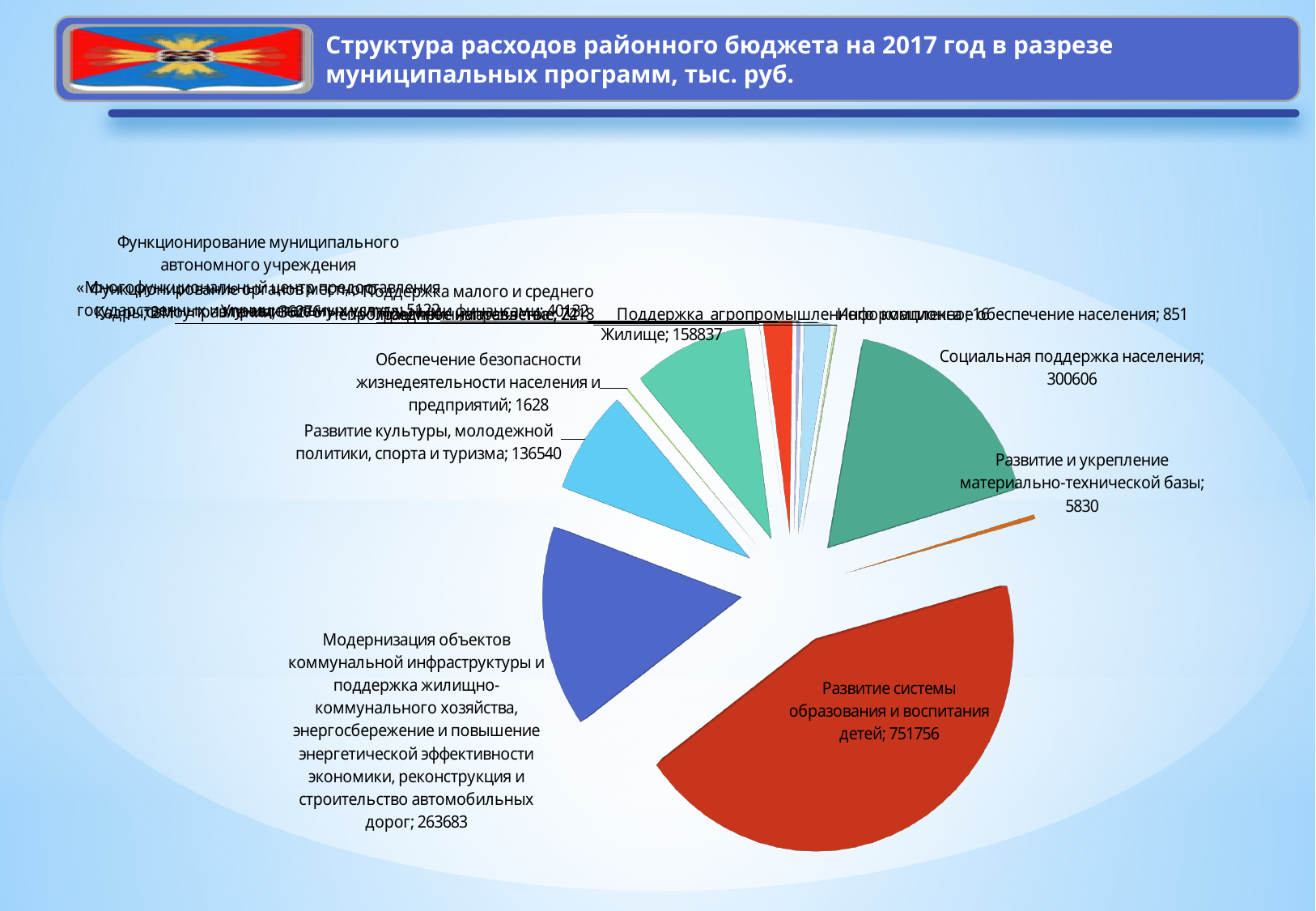
What kind of chart is shown on the slide? pie chart What is the value for «Социальная поддержка населения»? 300606 Which program has the largest slice of the pie? Развитие системы образования и воспитания детей What is the value for «Информационное обеспечение населения»? 851 What is the difference between «Жилище» and «Развитие культуры, молодежной политики, спорта и туризма»? 22297 What is the value for «Развитие культуры, молодежной политики, спорта и туризма»? 136540 What is the value for «Развитие и укрепление материально-технической базы»? 5830 What is the value for «Жилище»? 158837 What is the difference between «Развитие системы образования и воспитания детей» and «Социальная поддержка населения»? 451150 Which is larger: «Социальная поддержка населения» or «Жилище»? Социальная поддержка населения In what units are the values on the chart expressed, according to the slide title? тыс. руб. What is the value for «Развитие системы образования и воспитания детей»? 751756